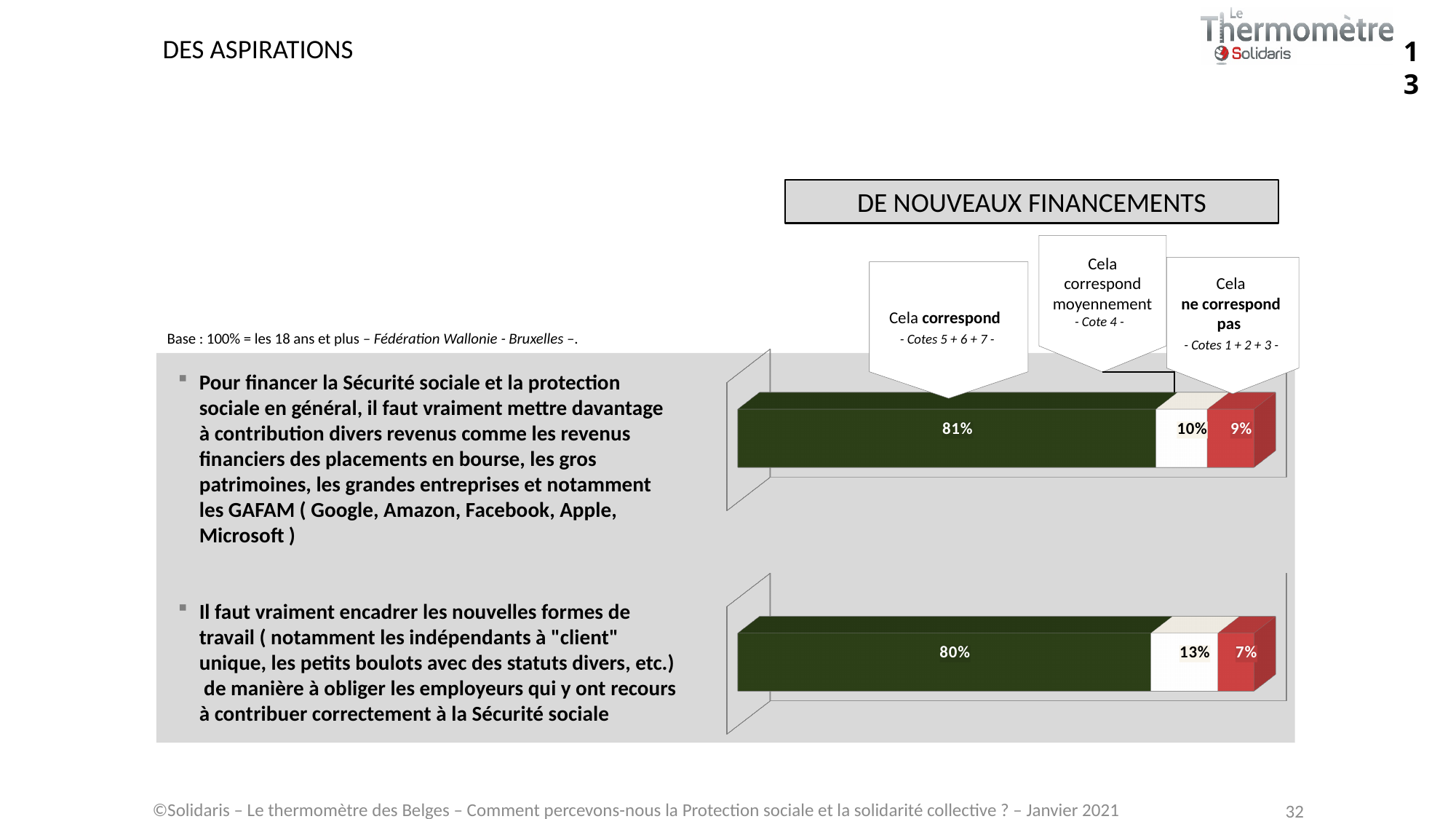
How many response categories are shown in each bar? 3 In the bottom chart, which response category has the highest value? Cela correspond In the bottom chart, what percentage is shown for 'Cela ne correspond pas'? 7% In the top chart, which response category has the lowest value? Cela ne correspond pas In the bottom chart (about regulating new forms of work), what percentage is shown for 'Cela correspond moyennement'? 13% In the top chart, what percentage is shown for 'Cela ne correspond pas'? 9% What is the title shown in the box above the charts? DE NOUVEAUX FINANCEMENTS What type of chart is used on this slide? Stacked bar chart In the top chart, what is the difference between 'Cela correspond' and 'Cela ne correspond pas'? 72 percentage points Which is larger: 'Cela correspond moyennement' in the top chart or in the bottom chart? Bottom chart (13%) What is the total of the three segments in the bottom chart's bar? 100% In the top chart (about financing social security through revenues such as GAFAM), what percentage is shown for 'Cela correspond'? 81%